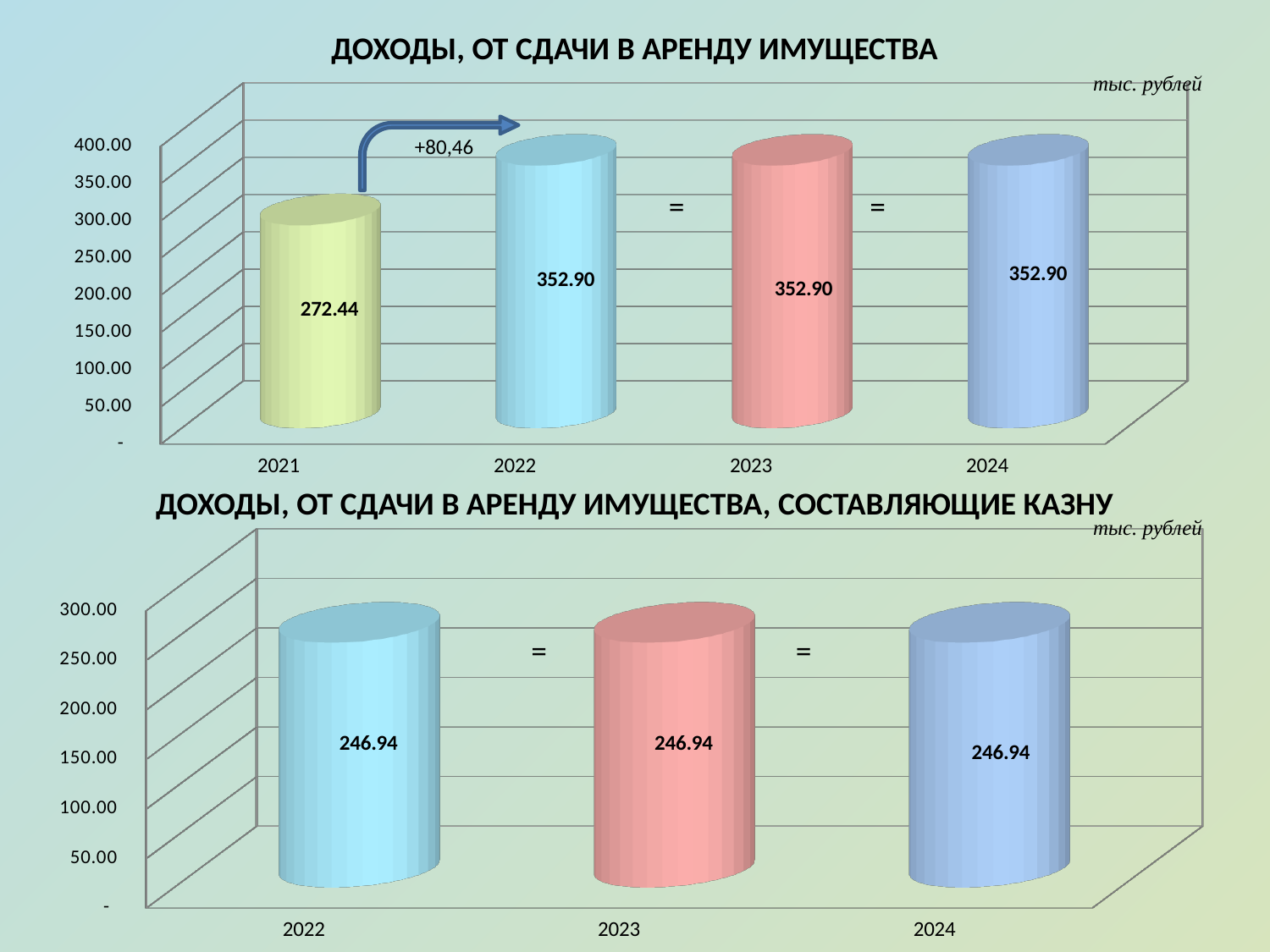
In the bottom chart 'ДОХОДЫ, ОТ СДАЧИ В АРЕНДУ ИМУЩЕСТВА, СОСТАВЛЯЮЩИЕ КАЗНУ', how many years are shown? 3 In the bottom chart 'ДОХОДЫ, ОТ СДАЧИ В АРЕНДУ ИМУЩЕСТВА, СОСТАВЛЯЮЩИЕ КАЗНУ', do the values rise, fall or stay the same from 2022 to 2024? stay the same In the top chart 'ДОХОДЫ, ОТ СДАЧИ В АРЕНДУ ИМУЩЕСТВА', what is the value for 2022? 352.90 In the top chart 'ДОХОДЫ, ОТ СДАЧИ В АРЕНДУ ИМУЩЕСТВА', which is larger, the value for 2021 or the value for 2024? 2024 In the top chart 'ДОХОДЫ, ОТ СДАЧИ В АРЕНДУ ИМУЩЕСТВА', which year has the lowest value? 2021 In the top chart 'ДОХОДЫ, ОТ СДАЧИ В АРЕНДУ ИМУЩЕСТВА', how many years are shown? 4 In what units are the values in the top chart 'ДОХОДЫ, ОТ СДАЧИ В АРЕНДУ ИМУЩЕСТВА' given? тыс. рублей What kind of chart is the bottom chart 'ДОХОДЫ, ОТ СДАЧИ В АРЕНДУ ИМУЩЕСТВА, СОСТАВЛЯЮЩИЕ КАЗНУ'? bar chart In the top chart 'ДОХОДЫ, ОТ СДАЧИ В АРЕНДУ ИМУЩЕСТВА', what is the difference between the values for 2022 and 2021? 80.46 In the top chart 'ДОХОДЫ, ОТ СДАЧИ В АРЕНДУ ИМУЩЕСТВА', is the value for 2021 greater or less than 300.00? less In the top chart 'ДОХОДЫ, ОТ СДАЧИ В АРЕНДУ ИМУЩЕСТВА', what is the value for 2021? 272.44 In the bottom chart 'ДОХОДЫ, ОТ СДАЧИ В АРЕНДУ ИМУЩЕСТВА, СОСТАВЛЯЮЩИЕ КАЗНУ', what is the value for 2023? 246.94